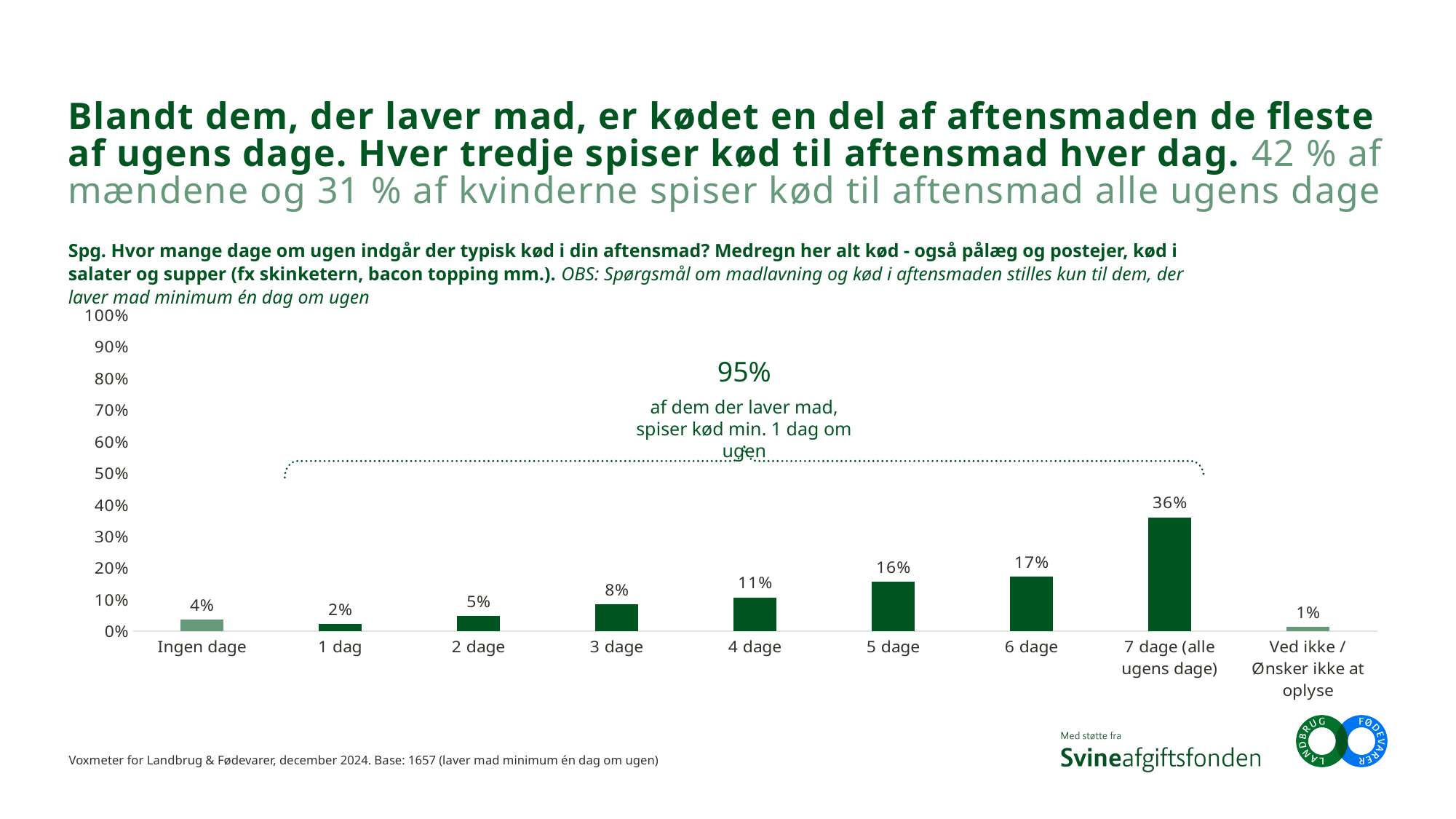
Which is larger, the value for '5 dage' or the value for '4 dage'? 5 dage Do the values rise or fall from '1 dag' to '7 dage (alle ugens dage)'? rise How many categories are shown on the x axis? 9 What is the difference between the values for '7 dage (alle ugens dage)' and '6 dage'? 19% What is the value for '7 dage (alle ugens dage)'? 36% What is the value for '3 dage'? 8% What percentage is shown in the annotation above the bracket spanning '1 dag' to '7 dage (alle ugens dage)'? 95% Which category has the lowest value? Ved ikke / Ønsker ikke at oplyse What kind of chart is shown on the slide? bar chart Is the value for '7 dage (alle ugens dage)' greater or less than 30%? greater What is the value for 'Ingen dage'? 4% Which category has the highest value? 7 dage (alle ugens dage)